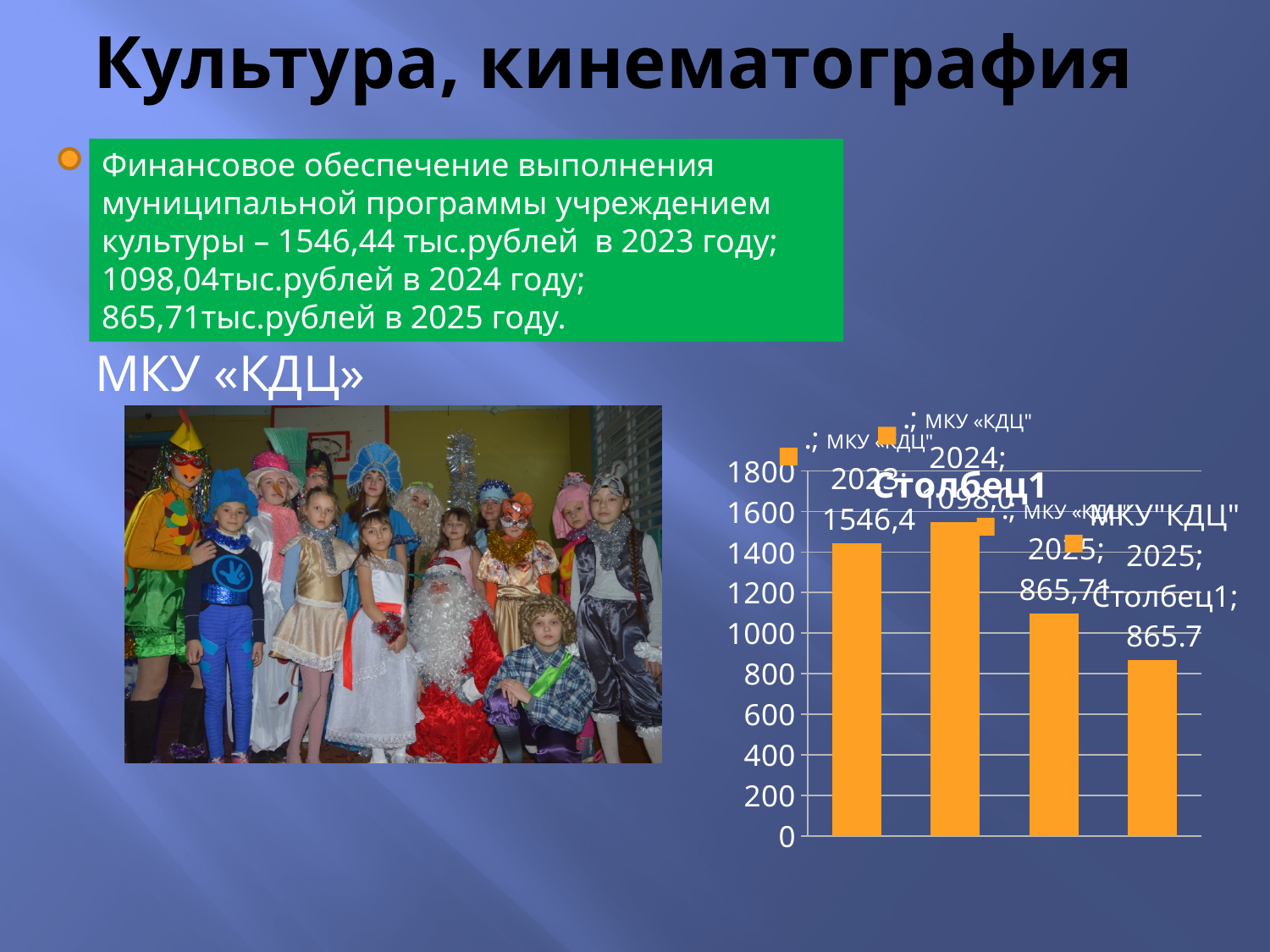
What is the highest value shown on the vertical axis of the chart? 1800 What value is labelled on the bar for МКУ «КДЦ» 2023? 1546,4 What kind of chart is shown on the slide? bar chart Is the bar for МКУ «КДЦ» 2024 greater or less than 1000? greater Which is larger, the bar for 2023 or the bar for 2024? 2023 Is the bar for МКУ «КДЦ» 2023 greater or less than 1400? greater How many bars are plotted in the chart? 4 What colour are the bars in the chart? orange What value is labelled on the third bar, for МКУ «КДЦ» 2025? 865,71 Is the bar for МКУ «КДЦ» 2025 greater or less than 1000? less